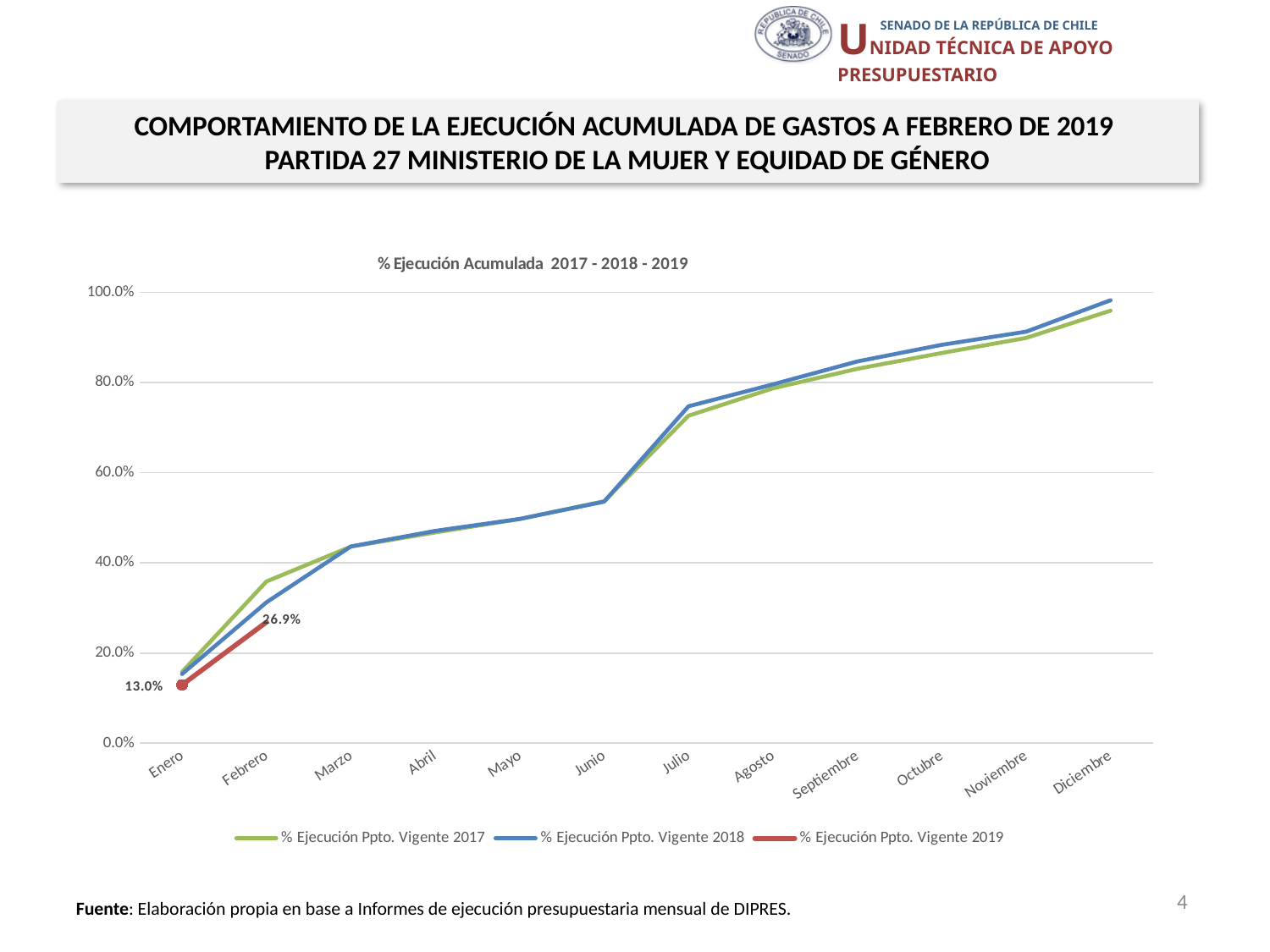
What kind of chart is shown on the slide? line chart How many series does the legend list? 3 Is the value for % Ejecución Ppto. Vigente 2017 in Julio greater or less than 60.0%? greater Is the value for % Ejecución Ppto. Vigente 2017 in Febrero greater or less than 40.0%? less What is the title of the chart? % Ejecución Acumulada 2017 - 2018 - 2019 Is the value for % Ejecución Ppto. Vigente 2018 in Diciembre greater or less than 80.0%? greater Does the % Ejecución Ppto. Vigente 2018 series rise or fall from Enero to Diciembre? rise In Febrero, which series has the larger value: % Ejecución Ppto. Vigente 2017 or % Ejecución Ppto. Vigente 2019? % Ejecución Ppto. Vigente 2017 What is the value of % Ejecución Ppto. Vigente 2019 for Enero? 13.0% What is the value of % Ejecución Ppto. Vigente 2019 for Febrero? 26.9% By how much did % Ejecución Ppto. Vigente 2019 increase from Enero to Febrero? 13.9% How many months are shown on the x axis? 12